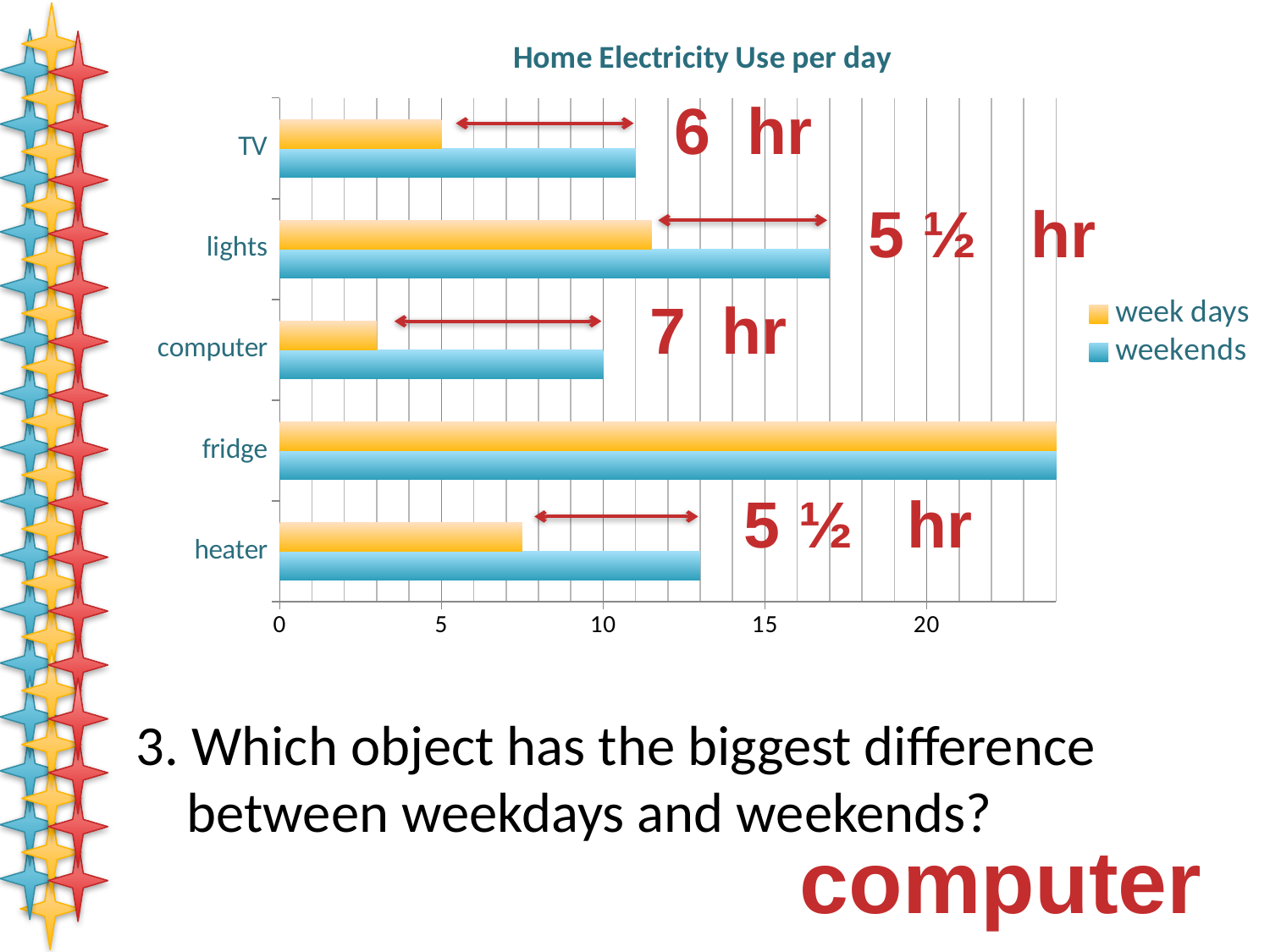
What kind of chart is shown on the slide? bar chart According to the annotation on the chart, what is the difference between weekdays and weekends for the computer? 7 hr Which has the larger weekends value, lights or heater? lights What is the weekends value for computer? 10 How many series does the legend list? 2 According to the annotation on the chart, what is the difference between weekdays and weekends for the TV? 6 hr Which object has the lowest week days value? computer What is the title of the chart? Home Electricity Use per day Which object has the highest weekends value? fridge How many categories (objects) are shown on the chart? 5 Is the weekends value for lights greater or less than 15? greater What is the week days value for TV? 5